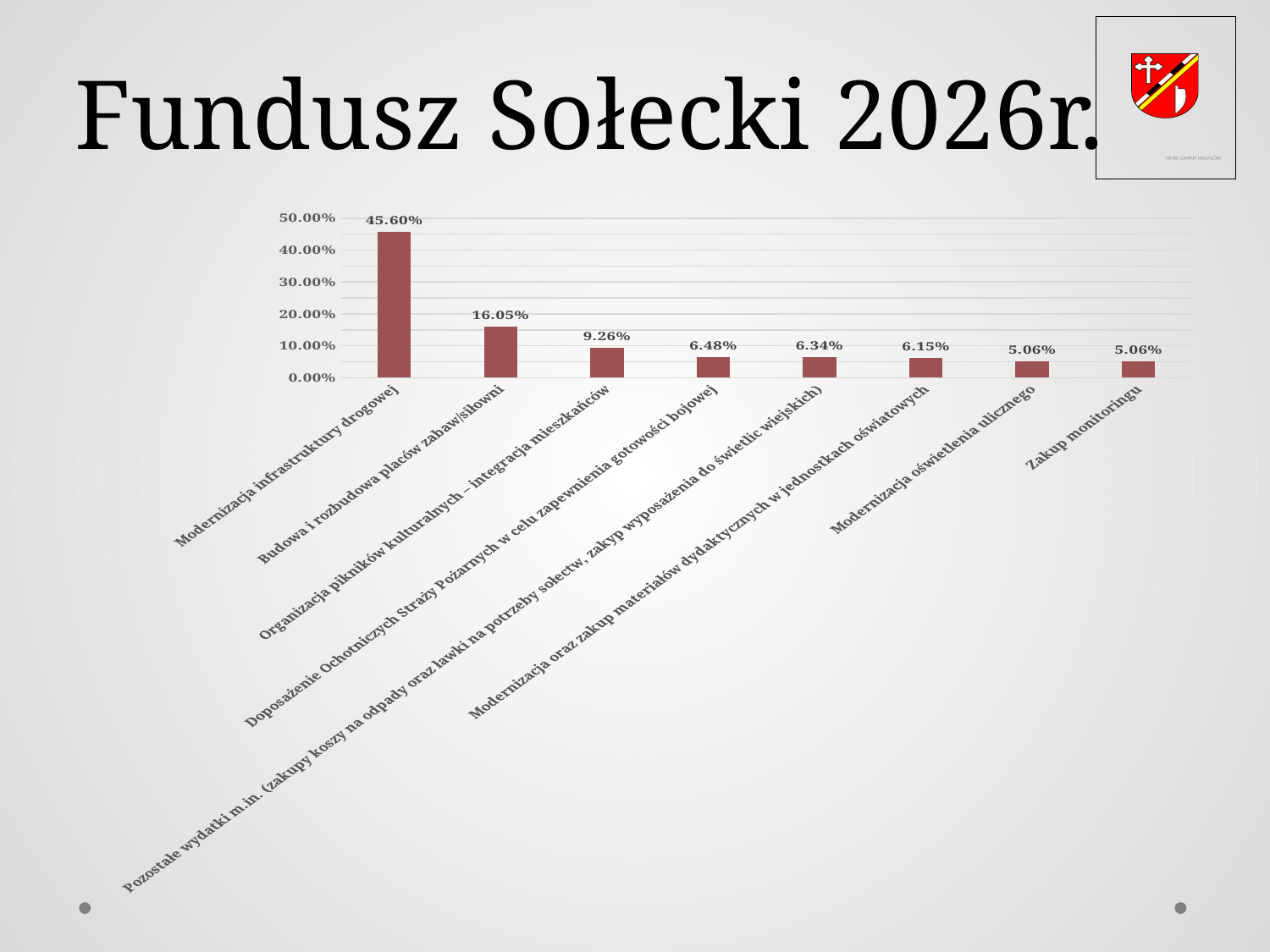
Which category has the highest value? Modernizacja infrastruktury drogowej What kind of chart is shown on the slide? bar chart Do the values rise or fall from left to right along the x axis? fall What is the value for Modernizacja oraz zakup materiałów dydaktycznych w jednostkach oświatowych? 6.15% Which is larger: the value for Organizacja pikników kulturalnych – integracja mieszkańców or the value for Modernizacja oświetlenia ulicznego? Organizacja pikników kulturalnych – integracja mieszkańców What is the difference between the values for Modernizacja infrastruktury drogowej and Budowa i rozbudowa placów zabaw/siłowni? 29.55% Is the value for Modernizacja infrastruktury drogowej greater or less than 40.00%? greater How many categories are shown in the chart? 8 What is the value for Budowa i rozbudowa placów zabaw/siłowni? 16.05% What is the difference between the values for Budowa i rozbudowa placów zabaw/siłowni and Organizacja pikników kulturalnych – integracja mieszkańców? 6.79% What is the value for Modernizacja infrastruktury drogowej? 45.60% What is the value for Zakup monitoringu? 5.06%